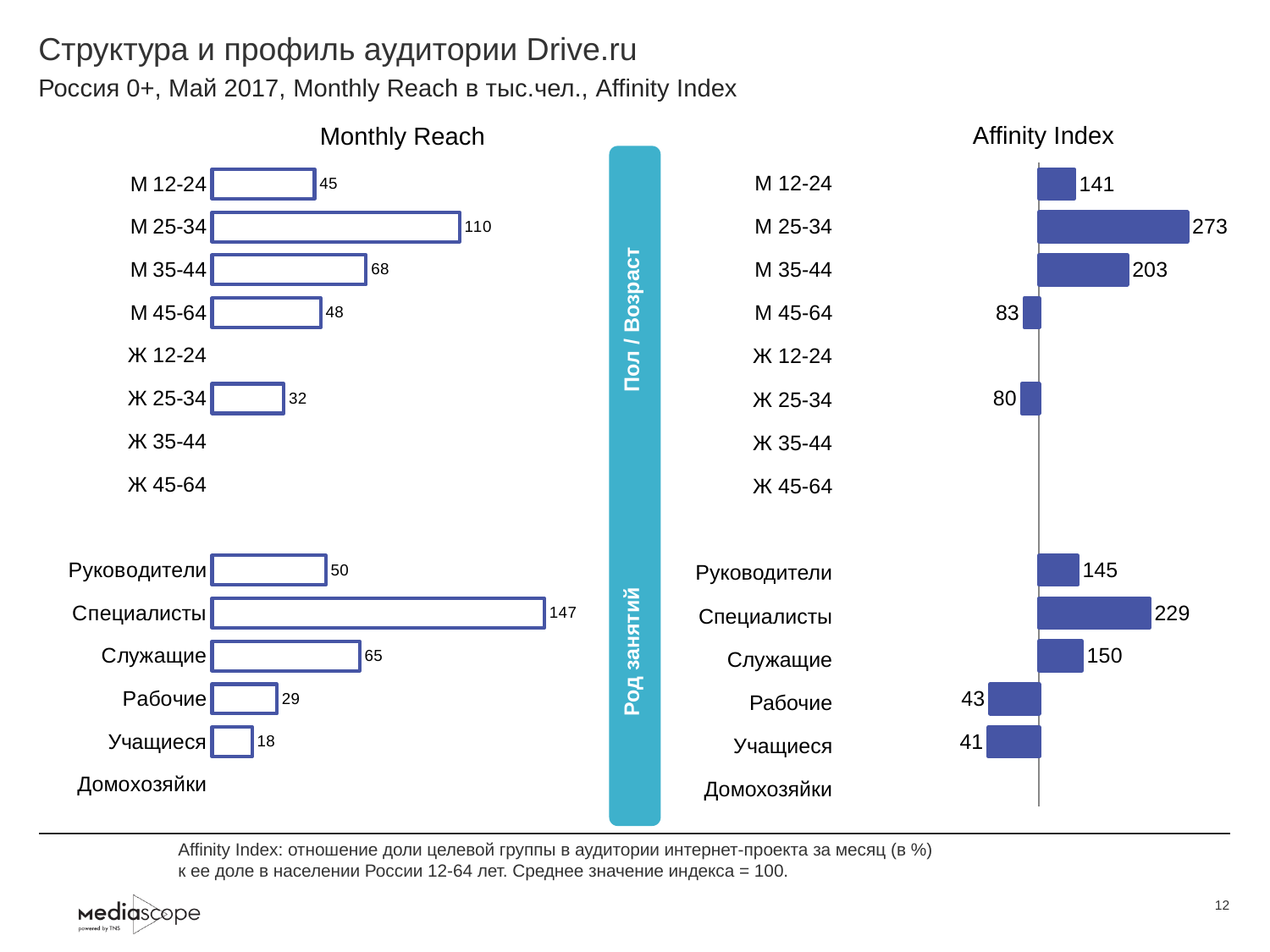
In the Monthly Reach chart, which is larger: the value for Руководители or the value for Служащие? Служащие What is the title of the chart on the right side of the slide? Affinity Index In the Affinity Index chart, which category has the lowest value? Учащиеся In the Monthly Reach chart, what is the value for Учащиеся? 18 In the Affinity Index chart, what is the value for Специалисты? 229 In the Monthly Reach chart, what is the difference between the values for М 35-44 and М 45-64? 20 In the Monthly Reach chart, what is the value for М 25-34? 110 In the Affinity Index chart, what is the difference between the values for М 25-34 and М 35-44? 70 In the Affinity Index chart, which is larger: the value for М 12-24 or the value for Служащие? Служащие What kind of chart is the Monthly Reach chart? Bar chart In the Monthly Reach chart, which category has the highest value? Специалисты In the Affinity Index chart, what is the value for Ж 25-34? 80